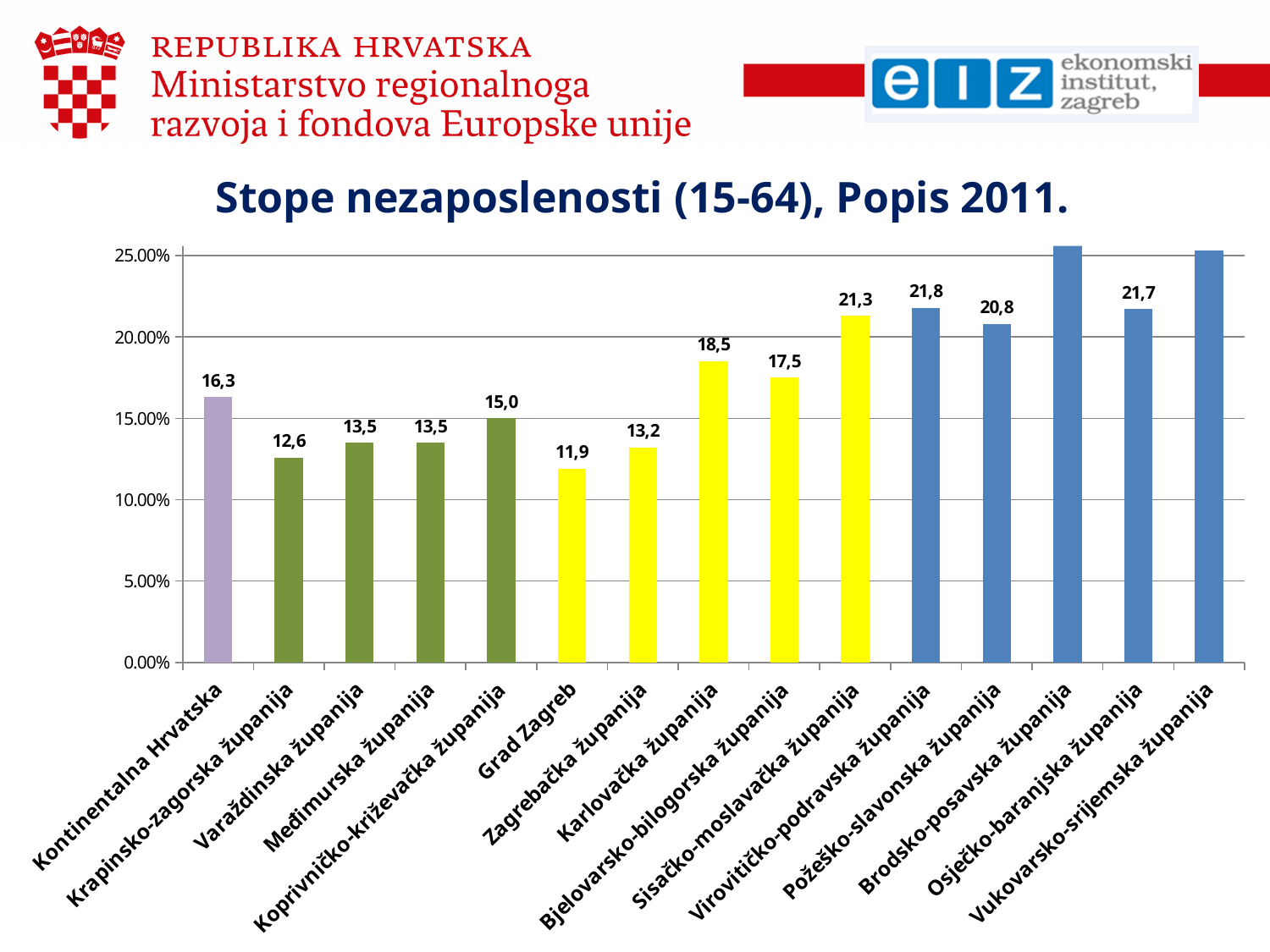
What is the difference between the values for Virovitičko-podravska županija and Požeško-slavonska županija? 1,0 What is the value for Karlovačka županija? 18,5 Is the value for Brodsko-posavska županija greater or less than 20.00%? greater What is the value for Kontinentalna Hrvatska? 16,3 What is the value for Sisačko-moslavačka županija? 21,3 What is the difference between the values for Karlovačka županija and Zagrebačka županija? 5,3 What kind of chart is shown on the slide? bar chart Which category has the lowest value? Grad Zagreb What is the value for Grad Zagreb? 11,9 Which is larger, the value for Bjelovarsko-bilogorska županija or the value for Koprivničko-križevačka županija? Bjelovarsko-bilogorska županija How many categories are shown on the x axis? 15 Is the value for Vukovarsko-srijemska županija greater or less than 20.00%? greater